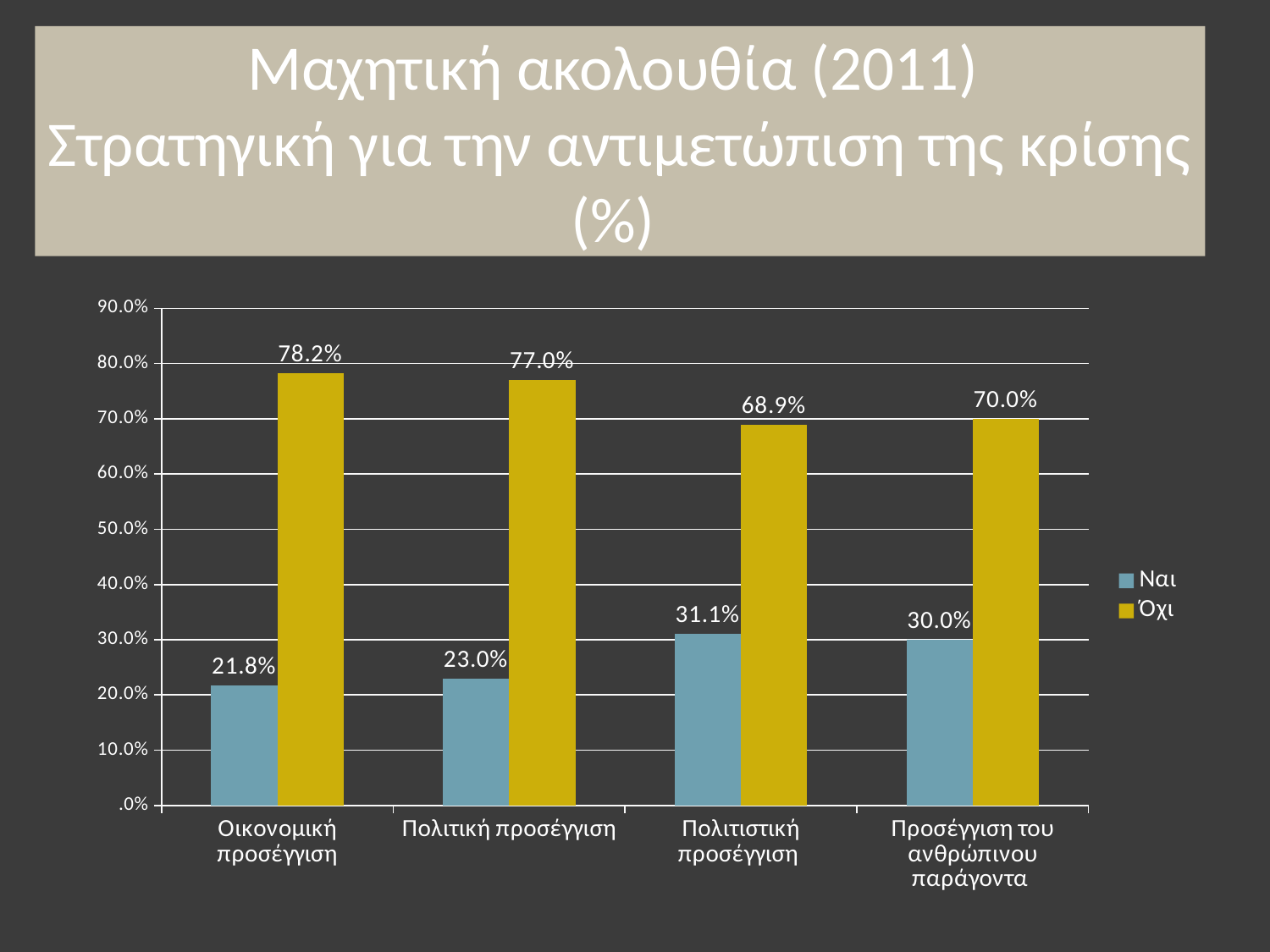
Is the Όχι value for Πολιτιστική προσέγγιση greater or less than 60.0%? greater What kind of chart is shown on the slide? bar chart Which is larger: the Ναι value for Πολιτιστική προσέγγιση or the Ναι value for Προσέγγιση του ανθρώπινου παράγοντα? Πολιτιστική προσέγγιση What is the difference between the Όχι and Ναι values for Πολιτιστική προσέγγιση? 37.8% What is the value of Όχι for Πολιτική προσέγγιση? 77.0% What is the value of Ναι for Οικονομική προσέγγιση? 21.8% Which category has the lowest Ναι value? Οικονομική προσέγγιση What is the value of Όχι for Προσέγγιση του ανθρώπινου παράγοντα? 70.0% How many series does the legend list? 2 What is the value of Ναι for Πολιτιστική προσέγγιση? 31.1% How many categories are shown on the x axis? 4 Which category has the highest Όχι value? Οικονομική προσέγγιση